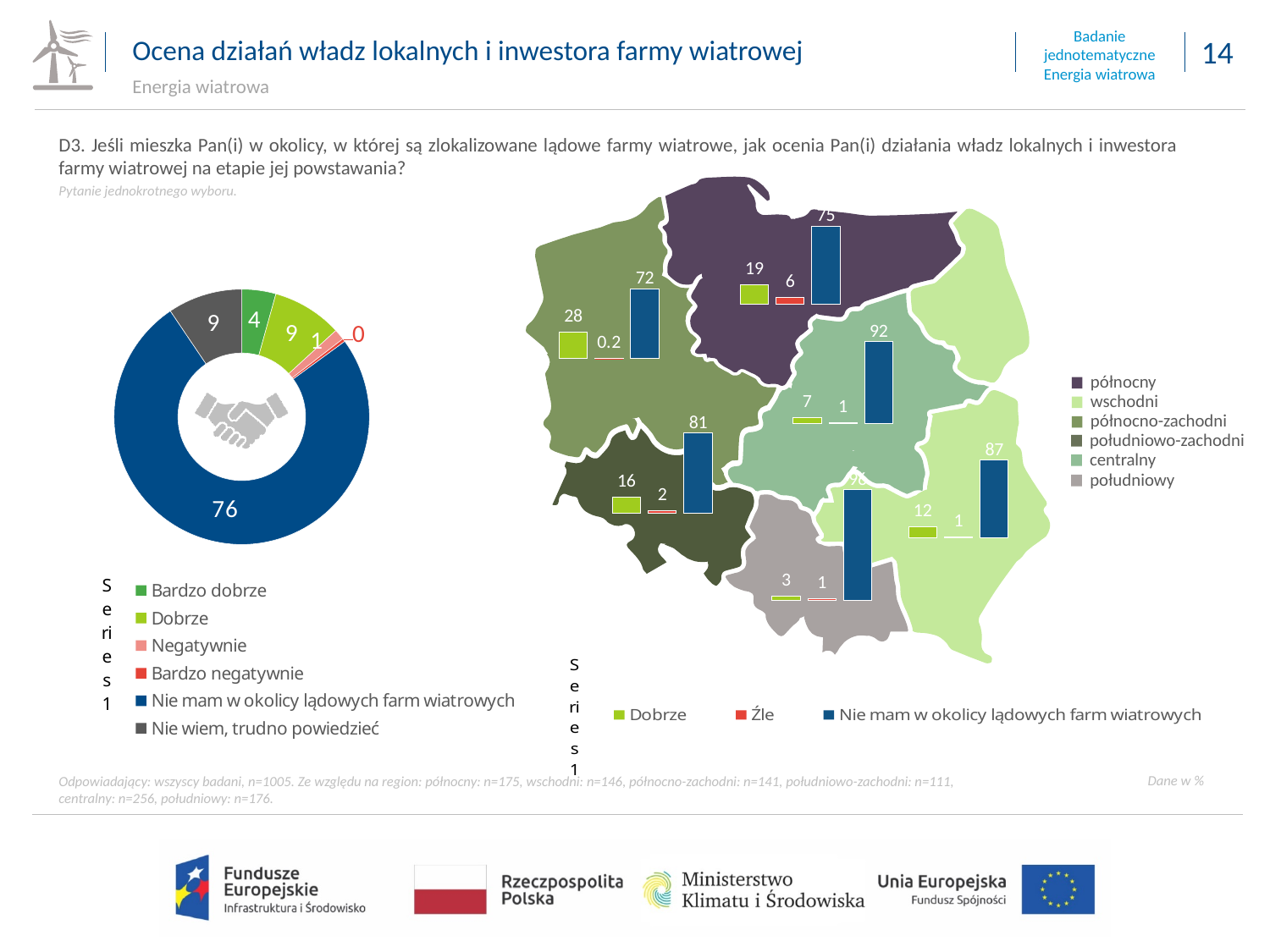
In the map chart on the right, which is larger: the 'Dobrze' value for the północny region or for the południowo-zachodni region? północny In the donut chart on the left, what percentage of respondents answered 'Nie mam w okolicy lądowych farm wiatrowych'? 76 How many categories does the legend of the donut chart on the left list? 6 In the map chart on the right, what is the value of 'Dobrze' for the północno-zachodni region? 28 In the donut chart on the left, which category has the largest share? Nie mam w okolicy lądowych farm wiatrowych How many series does the legend below the map chart list? 3 In the map chart on the right, what is the value of 'Nie mam w okolicy lądowych farm wiatrowych' for the centralny region? 92 In the donut chart on the left, what is the value for 'Bardzo dobrze'? 4 In the map chart on the right, what is the value of 'Źle' for the północny region? 6 What type of chart is shown on the left of the slide? Donut (pie) chart In the donut chart on the left, what is the value for 'Bardzo negatywnie'? 0 In the donut chart on the left, what is the difference between the values for 'Dobrze' and 'Bardzo dobrze'? 5